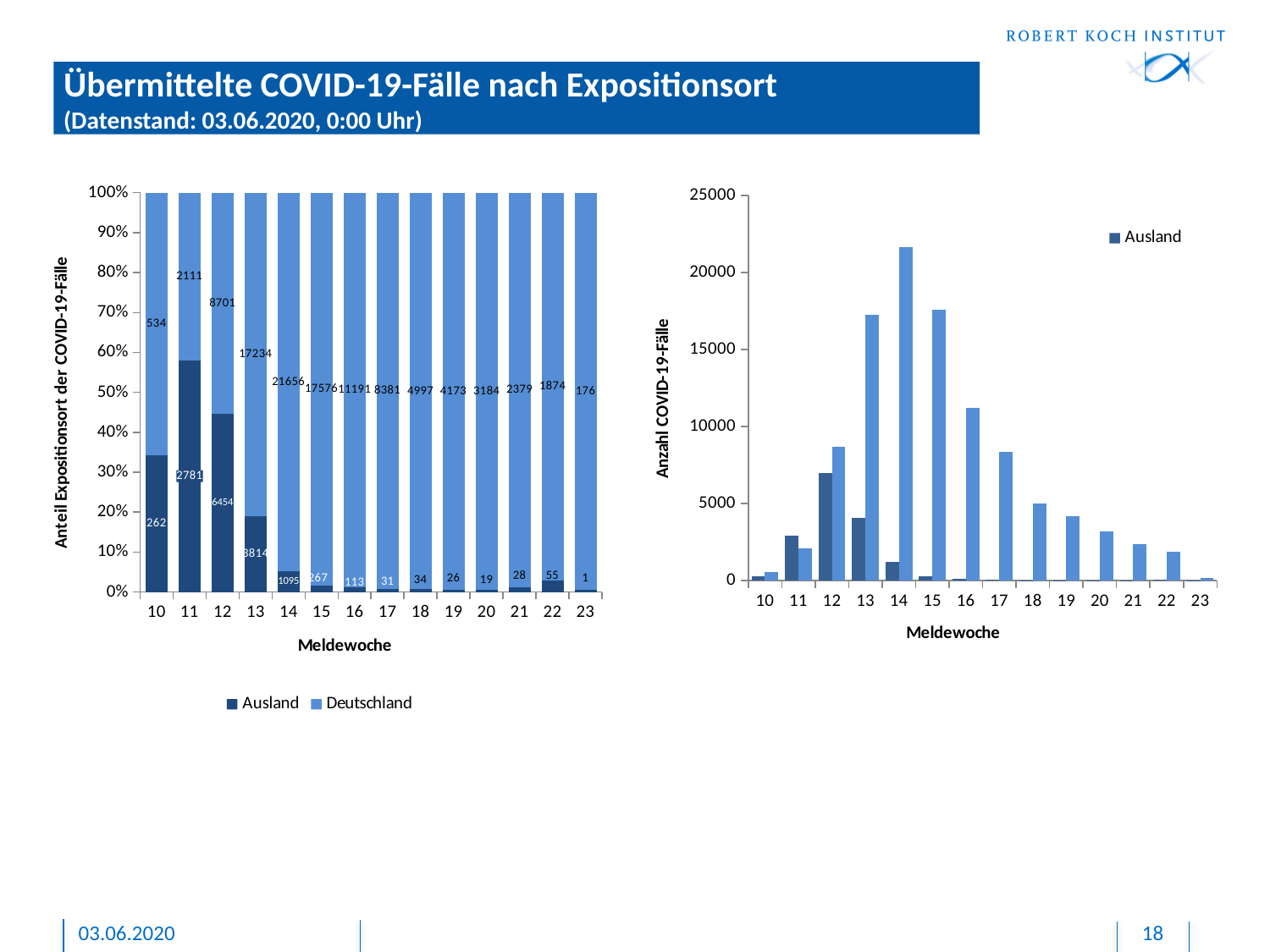
What kind of chart is the right chart (Anzahl COVID-19-Fälle)? bar chart In the left chart, what is the total of the Ausland and Deutschland values in Meldewoche 10? 796 In the right chart, is the value of the light blue bar for Meldewoche 13 greater or less than 15000? greater In the left chart, which is larger in Meldewoche 11, Ausland or Deutschland? Ausland In the left chart, what is the data label for Deutschland in Meldewoche 14? 21656 In the left chart, what is the difference between the Deutschland and Ausland values in Meldewoche 12? 2247 In the right chart, do the light blue bars rise or fall from Meldewoche 14 to Meldewoche 23? fall How many Meldewochen are shown on the x axis of the left chart? 14 How many series does the legend of the left chart list? 2 In the left chart, which Meldewoche has the lowest Ausland value? 23 In the left chart (Anteil Expositionsort der COVID-19-Fälle), what is the data label for Ausland in Meldewoche 11? 2781 In the left chart, which Meldewoche has the highest Deutschland value? 14